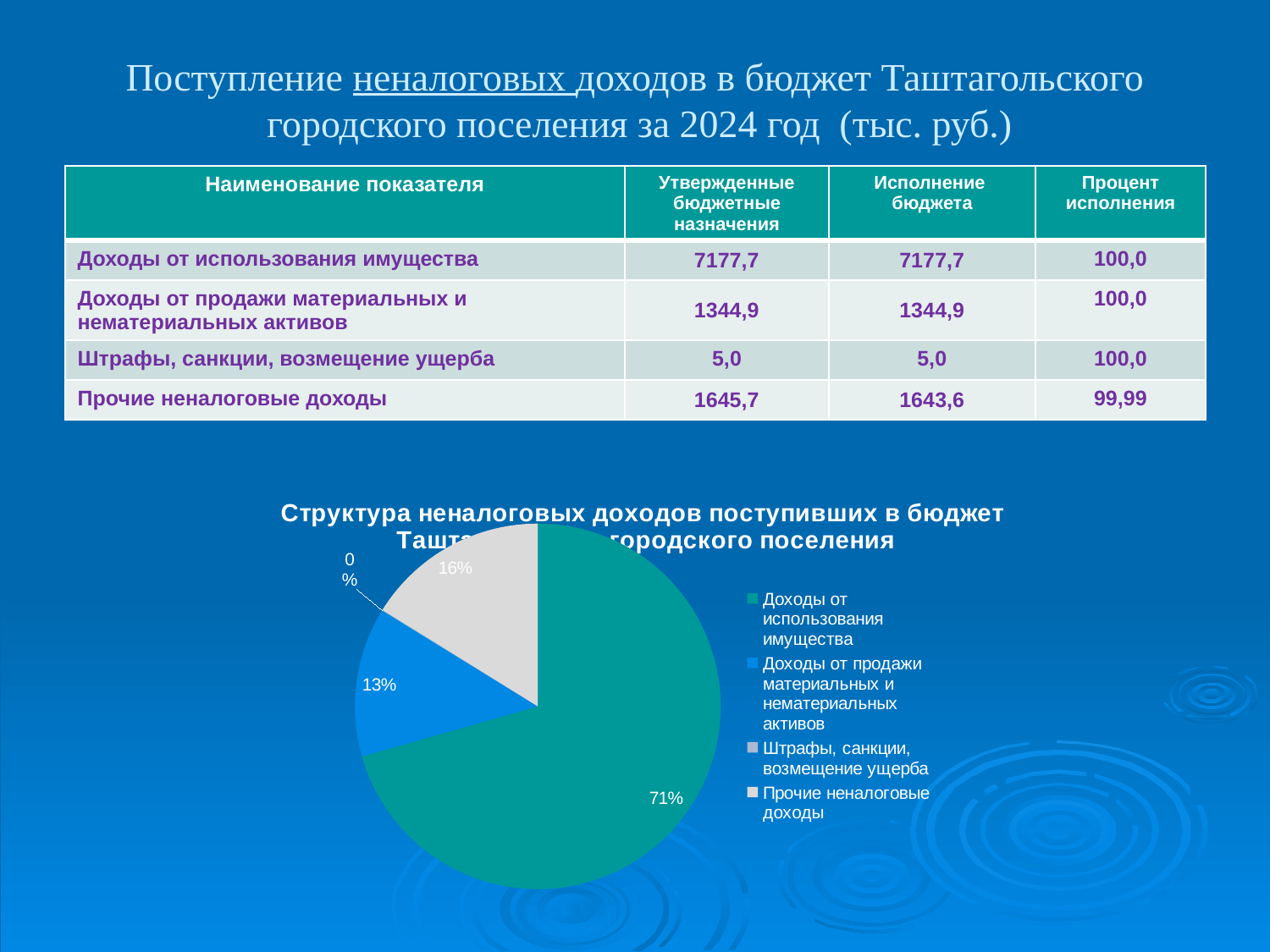
What share of the pie does "Штрафы, санкции, возмещение ущерба" hold? 0% What kind of chart is shown on the slide? pie chart Which slice is larger: "Прочие неналоговые доходы" or "Доходы от продажи материальных и нематериальных активов"? Прочие неналоговые доходы Which category has the largest slice of the pie? Доходы от использования имущества How many categories does the legend of the pie chart list? 4 By how many percentage points does the "Доходы от использования имущества" slice exceed the "Прочие неналоговые доходы" slice? 55 What share of the pie does "Доходы от продажи материальных и нематериальных активов" hold? 13% What colour is the slice for "Доходы от использования имущества" in the pie chart? teal (green) What share of the pie does "Доходы от использования имущества" hold? 71% How many slices are labelled with percentages on the pie chart? 4 Which category has the smallest slice of the pie? Штрафы, санкции, возмещение ущерба